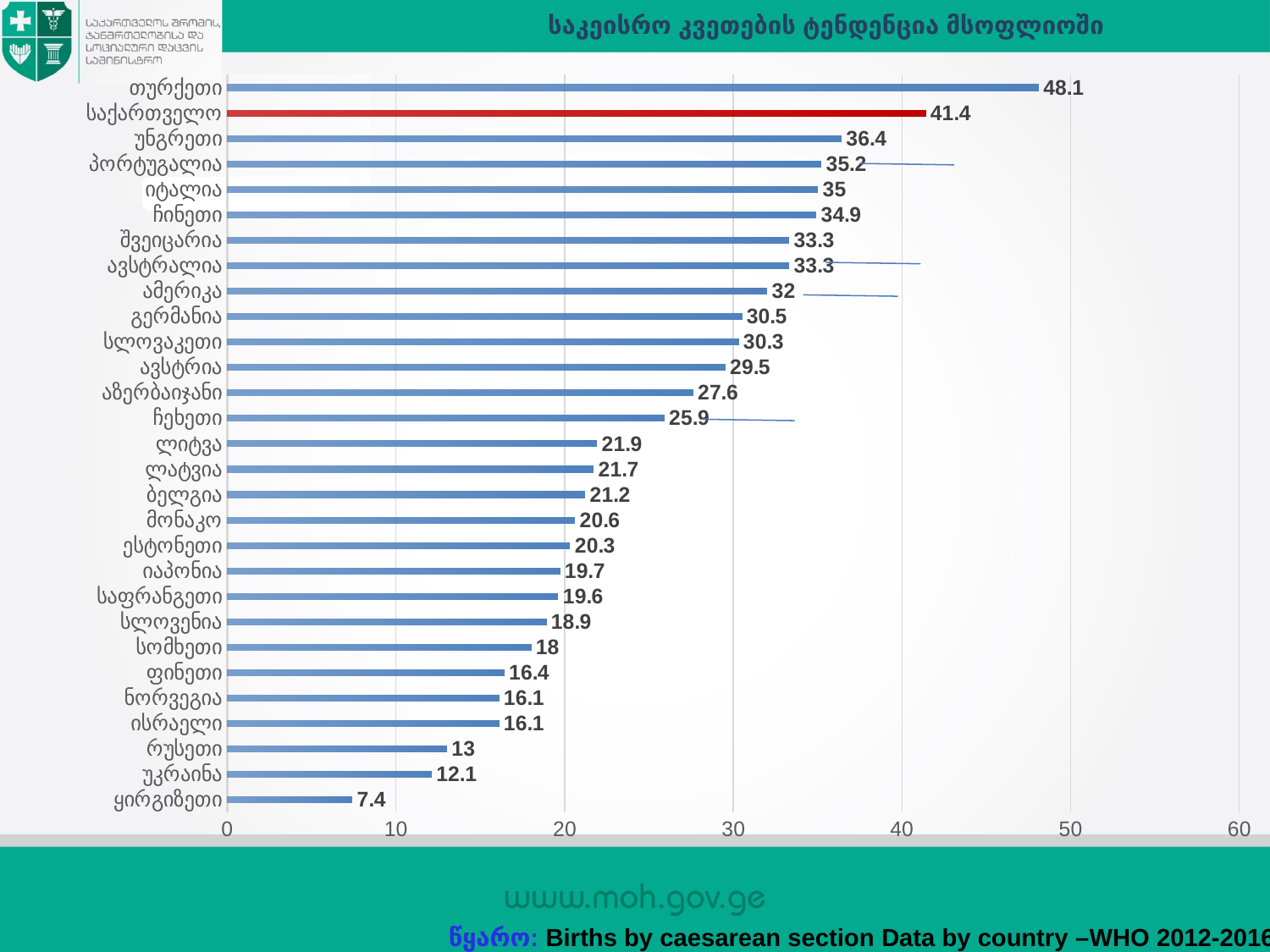
Which has a larger value, გერმანია or ავსტრია? გერმანია What is the value for ყირგიზეთი? 7.4 How many countries are shown in the chart? 29 What is the value for საქართველო? 41.4 What is the difference between the values for უკრაინა and რუსეთი? 0.9 What kind of chart is shown on the slide? bar chart Which country has the highest value? თურქეთი What is the difference between the values for თურქეთი and საქართველო? 6.7 What is the value for ჩინეთი? 34.9 Which country has the lowest value? ყირგიზეთი Which bar is highlighted in red? საქართველო Is the value for ამერიკა greater or less than 30? greater